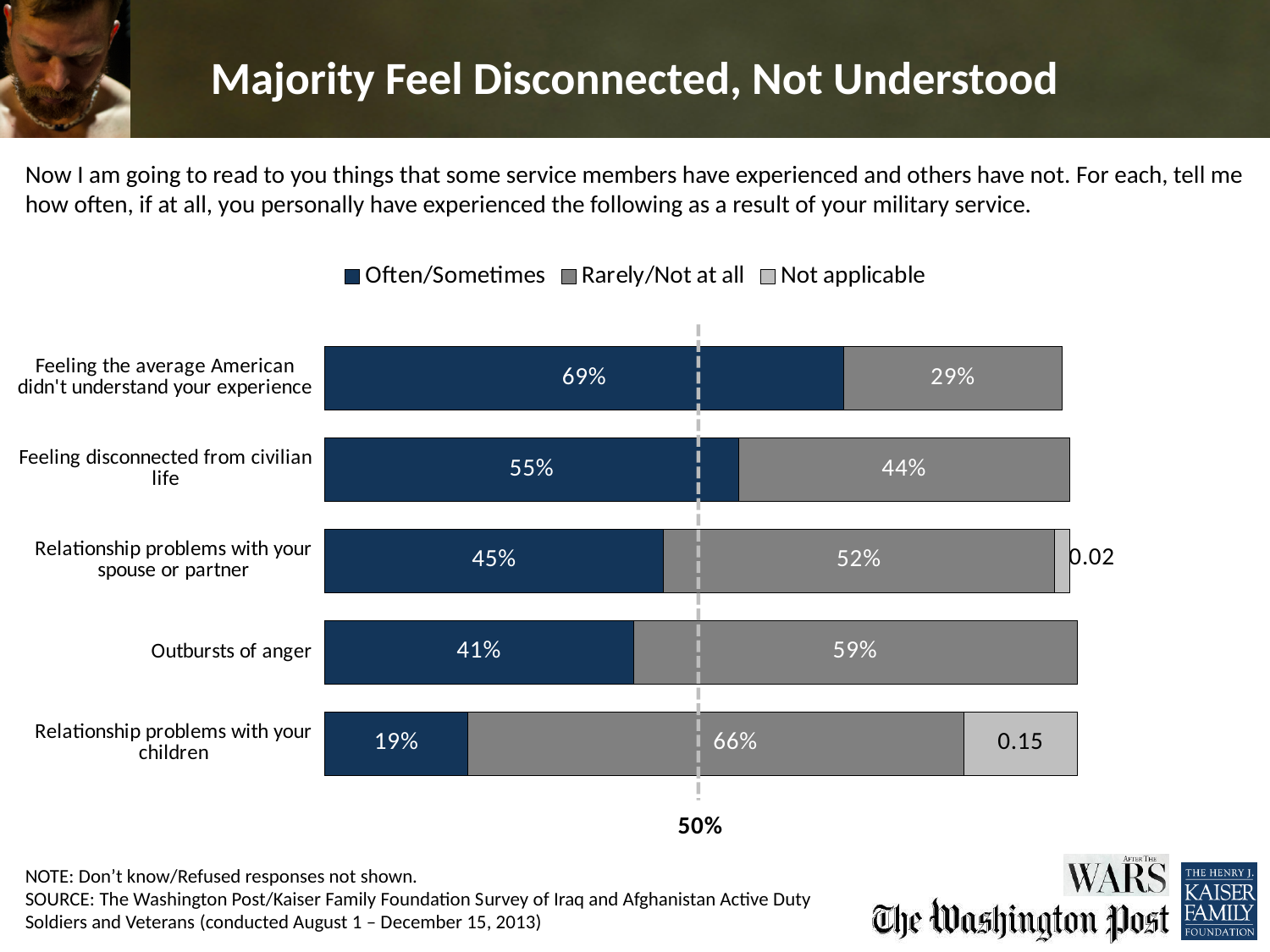
Which is larger: the Rarely/Not at all value for "Outbursts of anger" or for "Relationship problems with your spouse or partner"? Outbursts of anger What is the difference between the Often/Sometimes values for "Feeling disconnected from civilian life" and "Relationship problems with your spouse or partner"? 10% Which category has the lowest Often/Sometimes value? Relationship problems with your children Which category has the highest Often/Sometimes value? Feeling the average American didn't understand your experience What is the Not applicable value shown for "Relationship problems with your children"? 0.15 What is the Rarely/Not at all value for "Feeling disconnected from civilian life"? 44% What percentage of respondents said Often/Sometimes for "Feeling the average American didn't understand your experience"? 69% Is the Often/Sometimes value for "Feeling disconnected from civilian life" greater or less than 50%? greater What is the Often/Sometimes value for "Outbursts of anger"? 41% How many categories are shown in the chart? 5 What kind of chart is shown on the slide? Stacked bar chart How many series does the legend list? 3